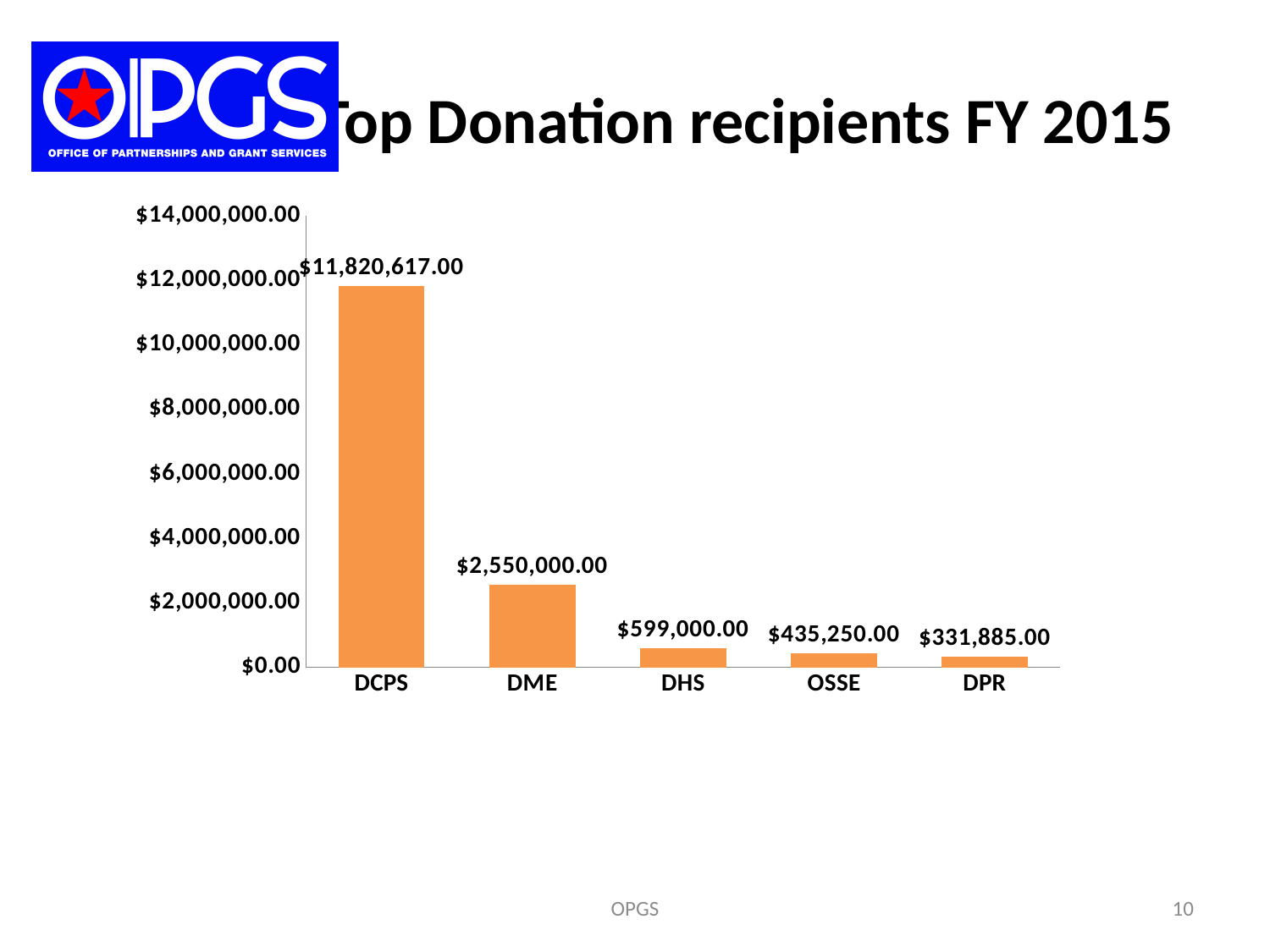
What kind of chart is shown on the slide? Bar chart What is the difference between the DCPS and DME donation values? $9,270,617.00 What is the difference between the DHS and OSSE donation values? $163,750.00 What is the donation value for OSSE? $435,250.00 Is the value for DME greater or less than $4,000,000.00? less How many recipients are shown in the chart? 5 Which recipient received the lowest donation amount? DPR What is the donation value for DPR? $331,885.00 Which received more in donations, DHS or OSSE? DHS Which recipient received the highest donation amount? DCPS What is the donation value for DCPS? $11,820,617.00 What is the donation value for DME? $2,550,000.00